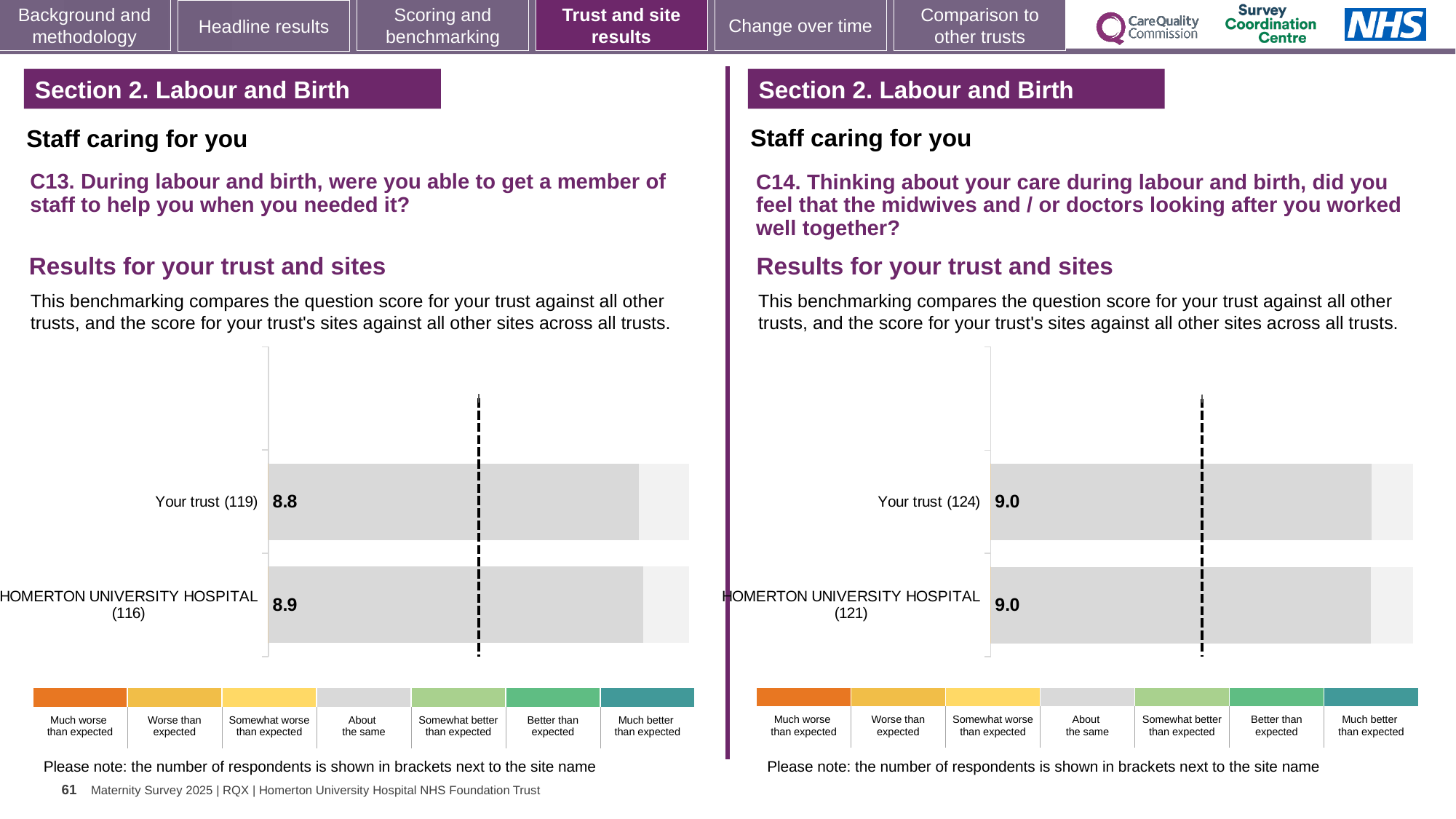
How many bars are plotted on the left chart (C13)? 2 On the right chart (C14), what is the score for Homerton University Hospital? 9.0 On the right chart (C14), what is the difference between the Your trust score and the Homerton University Hospital score? 0.0 On the left chart (C13), which category has the lowest score? Your trust On the right chart (C14), what is the score for Your trust? 9.0 On the left chart (C13), what is the score for Your trust? 8.8 On the left chart (C13), how many respondents are shown in brackets for Your trust? 119 On the left chart (C13), what is the score for Homerton University Hospital? 8.9 On the left chart (C13), what is the difference between the Homerton University Hospital score and the Your trust score? 0.1 On the left chart (C13), which has the higher score, Your trust or Homerton University Hospital? Homerton University Hospital What type of chart is used on the right (C14)? Bar chart On the right chart (C14), how many respondents are shown in brackets for Homerton University Hospital? 121